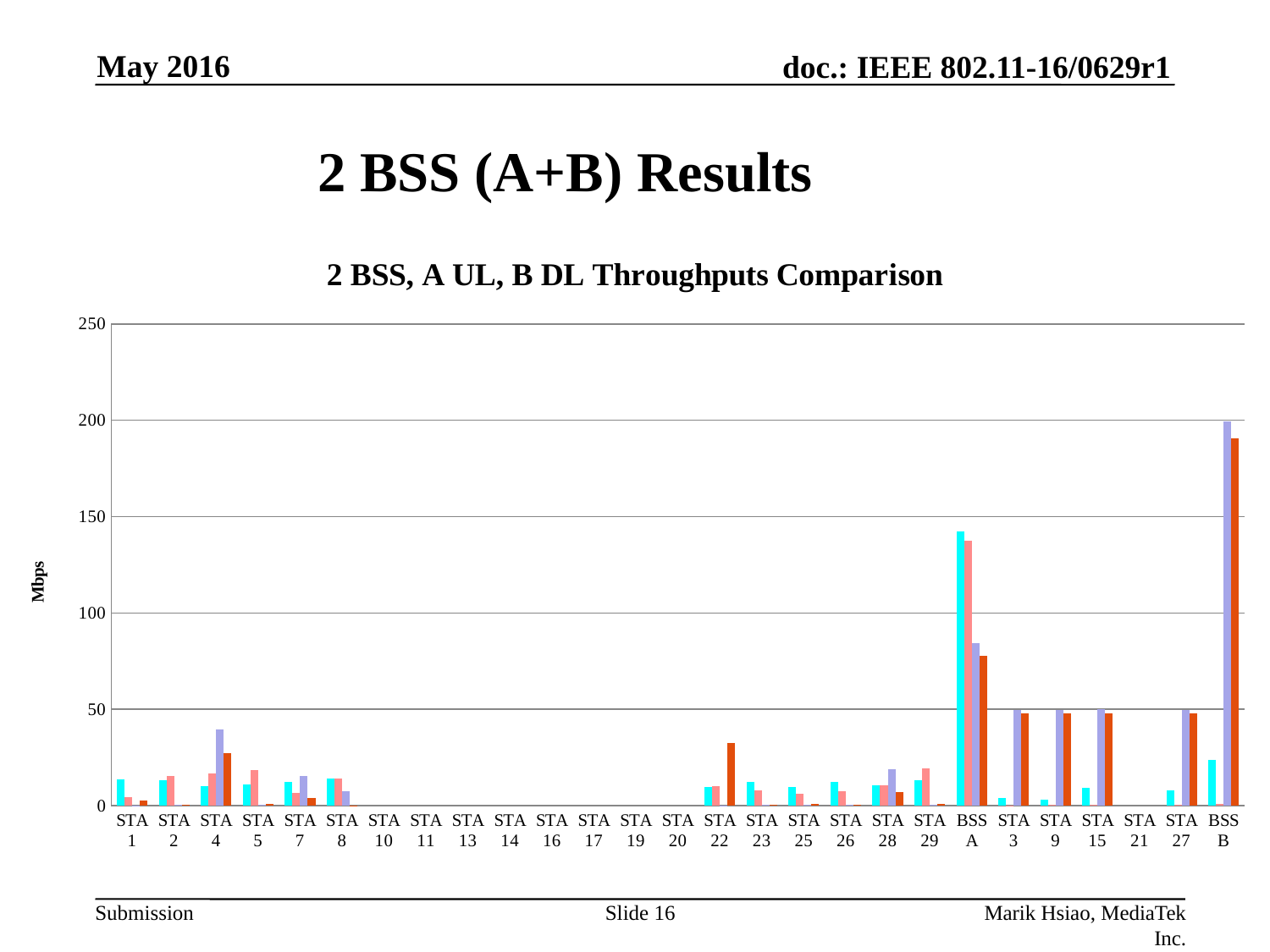
Is the tallest bar for STA 4 greater or less than 50? less Is the tallest bar for BSS B greater or less than 150? greater Is the tallest bar for BSS A greater or less than 150? less What kind of chart is shown on the slide? bar chart What is the label on the vertical axis of the chart? Mbps Which category has the tallest bar in the chart? BSS B Which has the taller highest bar, STA 1 or STA 4? STA 4 What is the title of the chart? 2 BSS, A UL, B DL Throughputs Comparison How many categories are shown along the x axis of the chart? 27 Which has the taller highest bar, BSS A or BSS B? BSS B